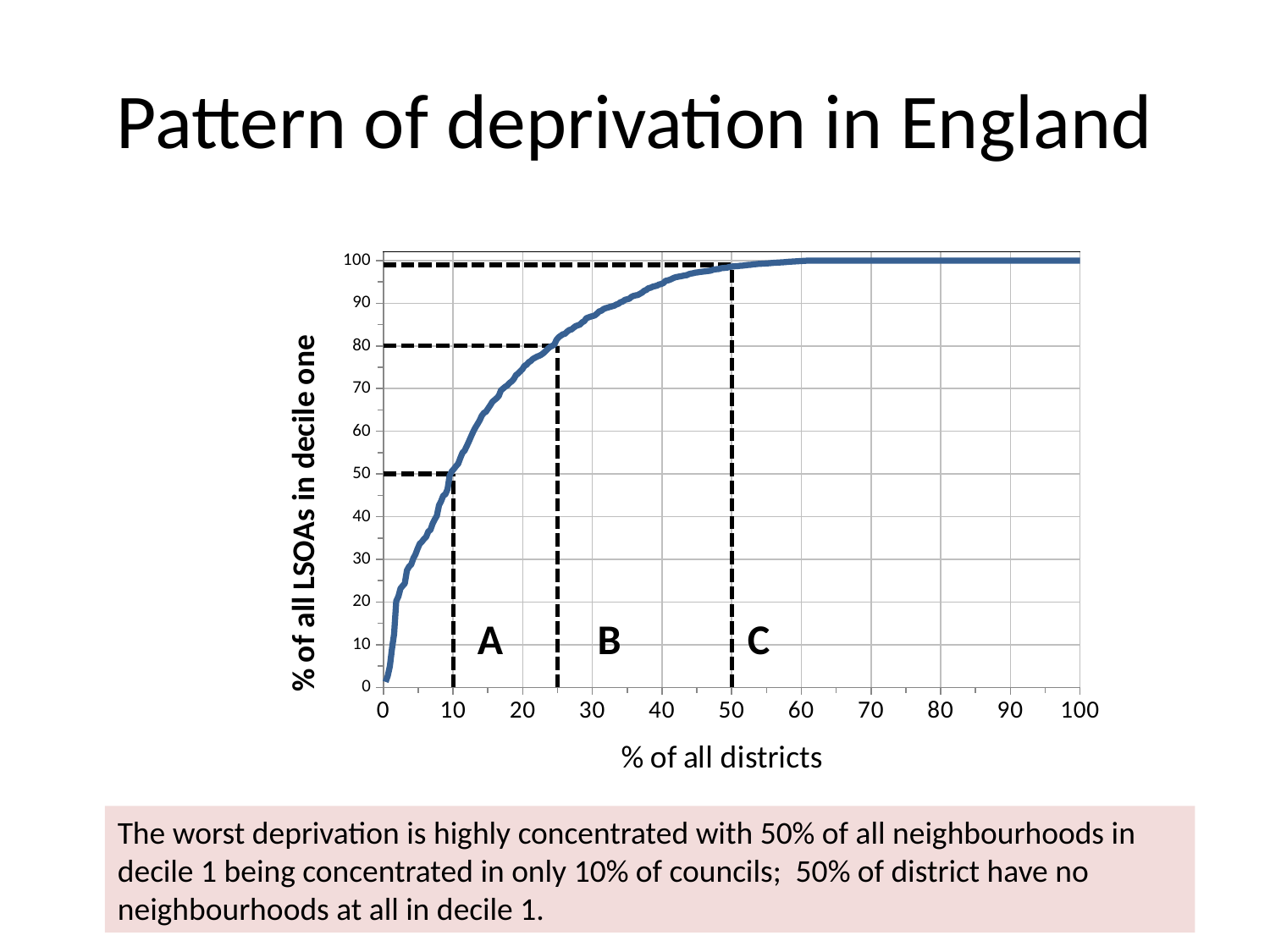
Which is larger: the curve's value at 25% of all districts or at 10% of all districts? 25% of all districts What type of chart is shown on the slide? line chart Does the curve rise or fall as the percentage of all districts increases? rises According to the dashed guide lines, what percentage of all LSOAs in decile one is reached at 25% of all districts? 80 Is the value of the curve at 40% of all districts greater or less than 90? greater According to the dashed guide lines, what percentage of all LSOAs in decile one is reached at 10% of all districts? 50 How many lettered regions (A, B, C) are marked along the bottom of the chart? 3 Is the value of the curve at 50% of all districts greater or less than 90? greater What is the title of the y axis? % of all LSOAs in decile one What is the title of the x axis? % of all districts Is the value of the curve at 5% of all districts greater or less than 30? greater